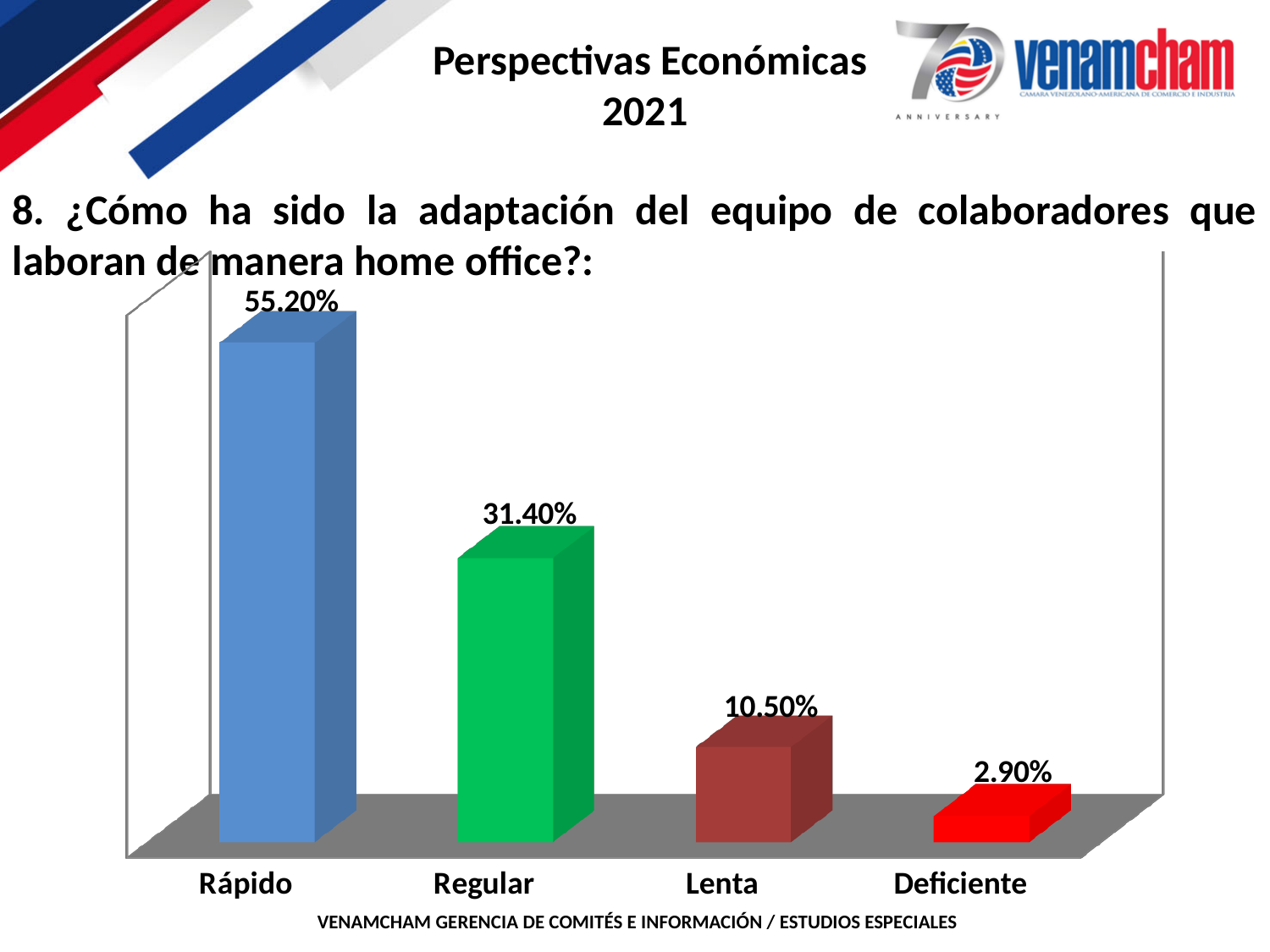
What is the value for Rápido? 55.20% Which is larger, the value for Regular or the value for Lenta? Regular Which category has the lowest value? Deficiente What is the difference between the values for Lenta and Deficiente? 7.60% What is the value for Regular? 31.40% What is the value for Deficiente? 2.90% What is the value for Lenta? 10.50% Which category has the highest value? Rápido What kind of chart is shown on the slide? Bar chart How many categories are shown in the chart? 4 Do the values rise or fall from left to right along the x axis? Fall What is the difference between the values for Rápido and Regular? 23.80%